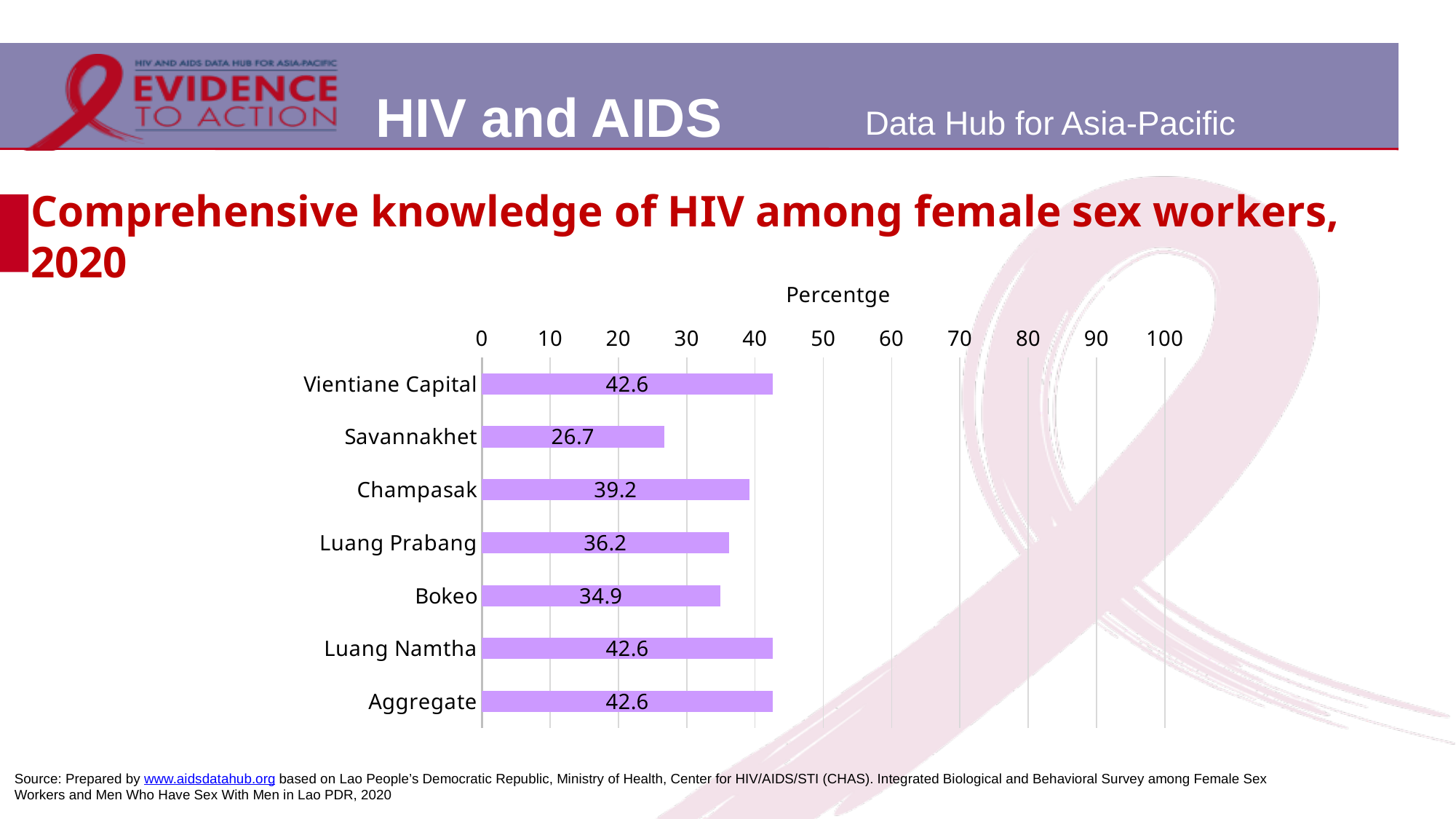
What is the Aggregate value? 42.6 What is the difference between the values for Champasak and Bokeo? 4.3 How many categories are shown on the chart? 7 What is the title of the horizontal axis? Percentge What is the value for Savannakhet? 26.7 What is the value for Champasak? 39.2 What is the difference between the values for Vientiane Capital and Savannakhet? 15.9 Which province has the lowest value? Savannakhet Which is larger, the value for Luang Prabang or the value for Savannakhet? Luang Prabang What is the value for Bokeo? 34.9 What is the value for Luang Prabang? 36.2 What kind of chart is shown on the slide? Bar chart